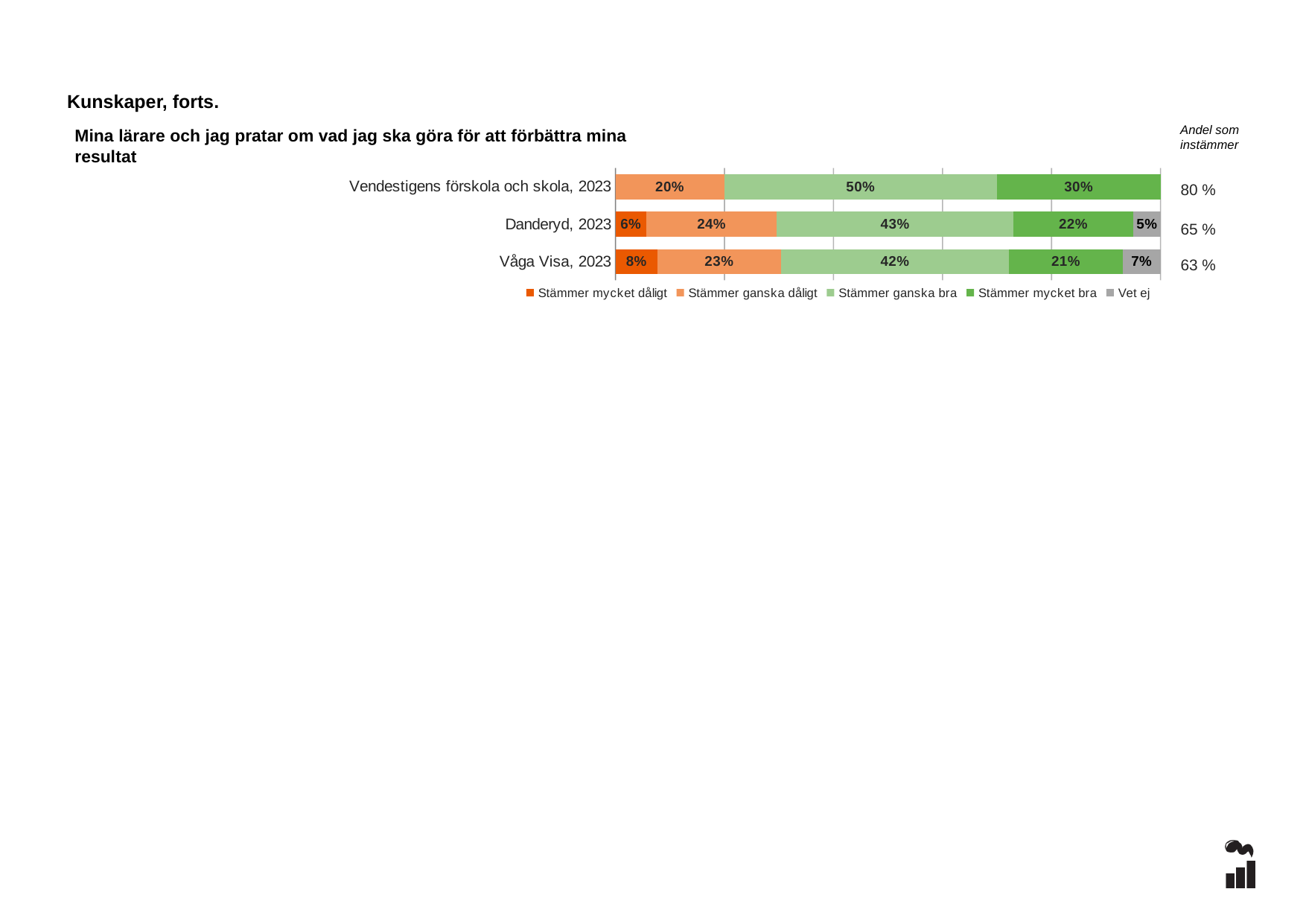
Which category has the lowest "Andel som instämmer" figure? Våga Visa, 2023 What is the value for "Vet ej" for Danderyd, 2023? 5% How many categories (bars) are shown in the chart? 3 Which is larger: the "Stämmer ganska dåligt" value for Danderyd, 2023 or for Våga Visa, 2023? Danderyd, 2023 How many series does the legend list? 5 Which category has the highest value for "Stämmer mycket bra"? Vendestigens förskola och skola, 2023 What is the difference between the "Stämmer ganska bra" values for Vendestigens förskola och skola, 2023 and Danderyd, 2023? 7 percentage points What kind of chart is shown on the slide? Stacked bar chart What is the "Andel som instämmer" figure shown for Vendestigens förskola och skola, 2023? 80 % What is the title of the chart? Mina lärare och jag pratar om vad jag ska göra för att förbättra mina resultat What is the value for "Stämmer mycket dåligt" for Våga Visa, 2023? 8% What is the value for "Stämmer ganska bra" for Vendestigens förskola och skola, 2023? 50%